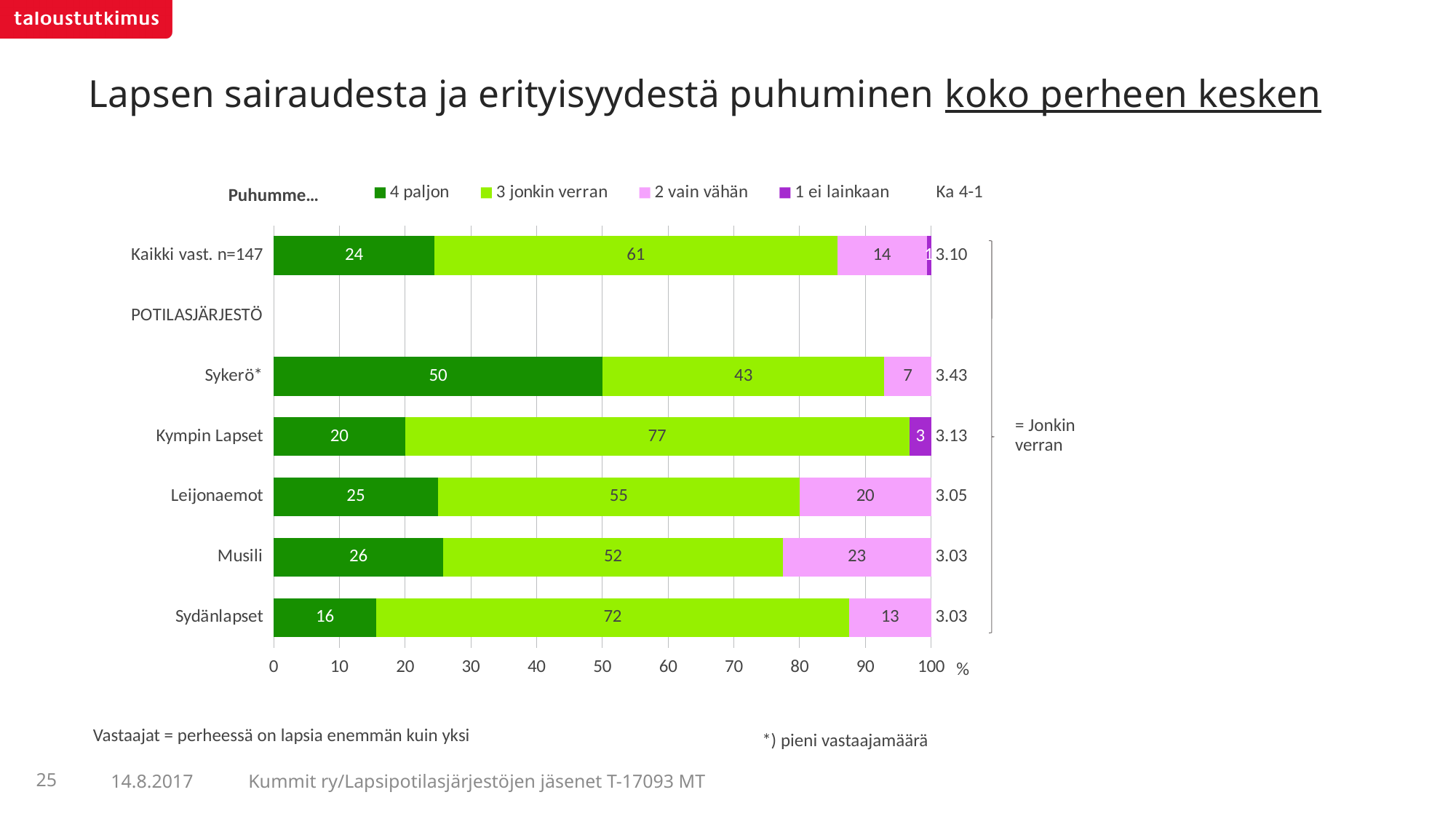
Which group has the highest "4 paljon" share? Sykerö* Which is larger, the "2 vain vähän" value for Leijonaemot or for Sydänlapset? Leijonaemot Is the "3 jonkin verran" value for Kaikki vast. n=147 greater or less than 50? greater What is the difference between the "3 jonkin verran" values for Kympin Lapset and Sydänlapset? 5 What type of chart is shown on the slide? Stacked bar chart What is the Ka 4-1 mean value shown for Sykerö*? 3.43 What is the "2 vain vähän" value for Musili? 23 What percentage of Sykerö* respondents answered "4 paljon"? 50 Which legend entry is shown in dark purple? 1 ei lainkaan How many series does the legend list (excluding the Ka 4-1 label)? 4 What is the "3 jonkin verran" value for Kympin Lapset? 77 Which group has the lowest "4 paljon" share? Sydänlapset